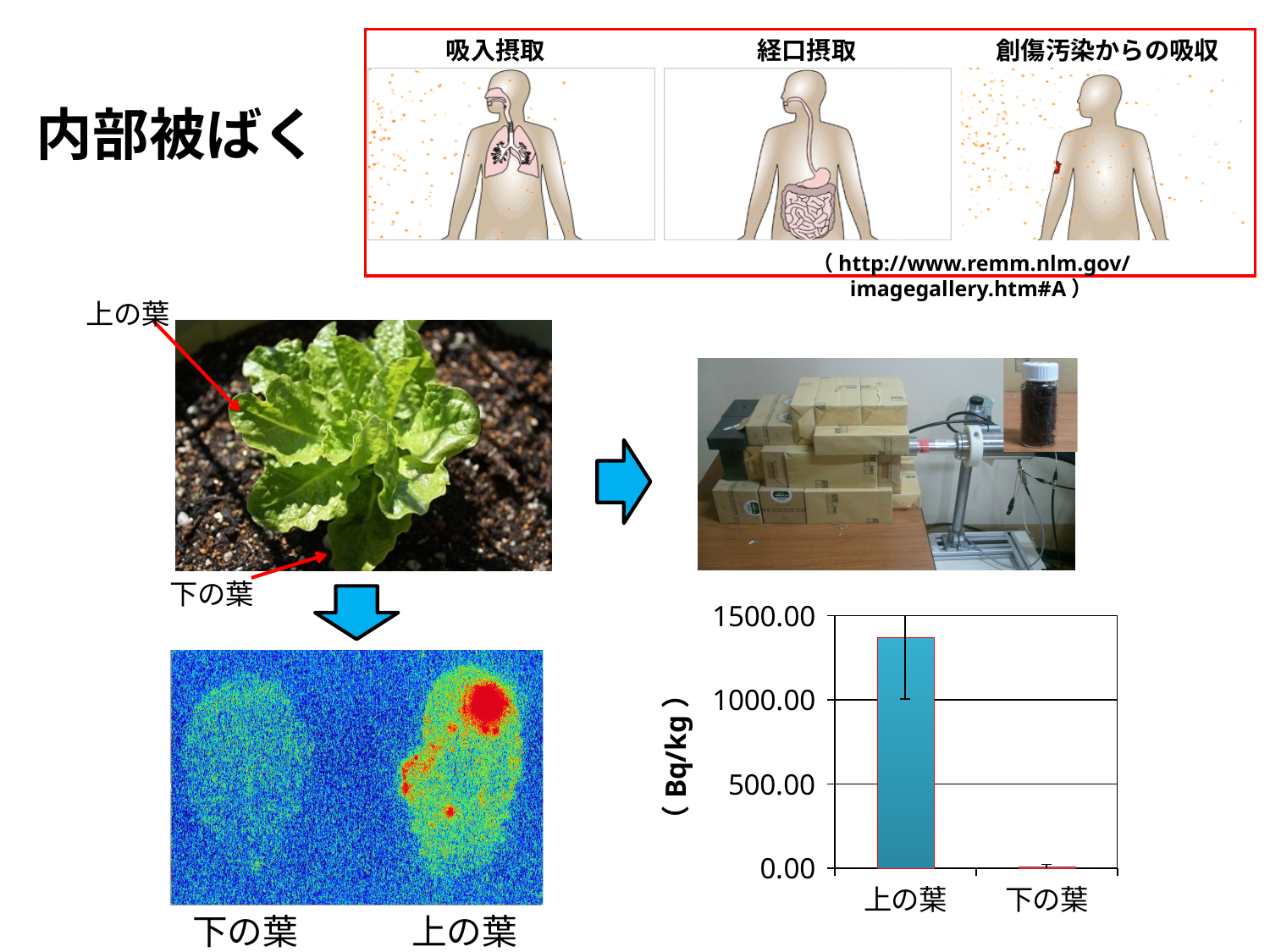
Is the value for 上の葉 in the bar chart greater or less than 1500.00? less What unit is shown on the y axis of the bar chart? Bq/kg What kind of chart is shown at the bottom right of the slide? bar chart What is the highest tick value shown on the y axis of the bar chart? 1500.00 Which category has the highest value in the bar chart? 上の葉 Is the value for 上の葉 in the bar chart greater or less than 1000.00? greater Which category has the lowest value in the bar chart? 下の葉 Is the value for 下の葉 in the bar chart greater or less than 500.00? less In the bar chart, which is larger, the value for 上の葉 or the value for 下の葉? 上の葉 How many categories are plotted on the x axis of the bar chart? 2